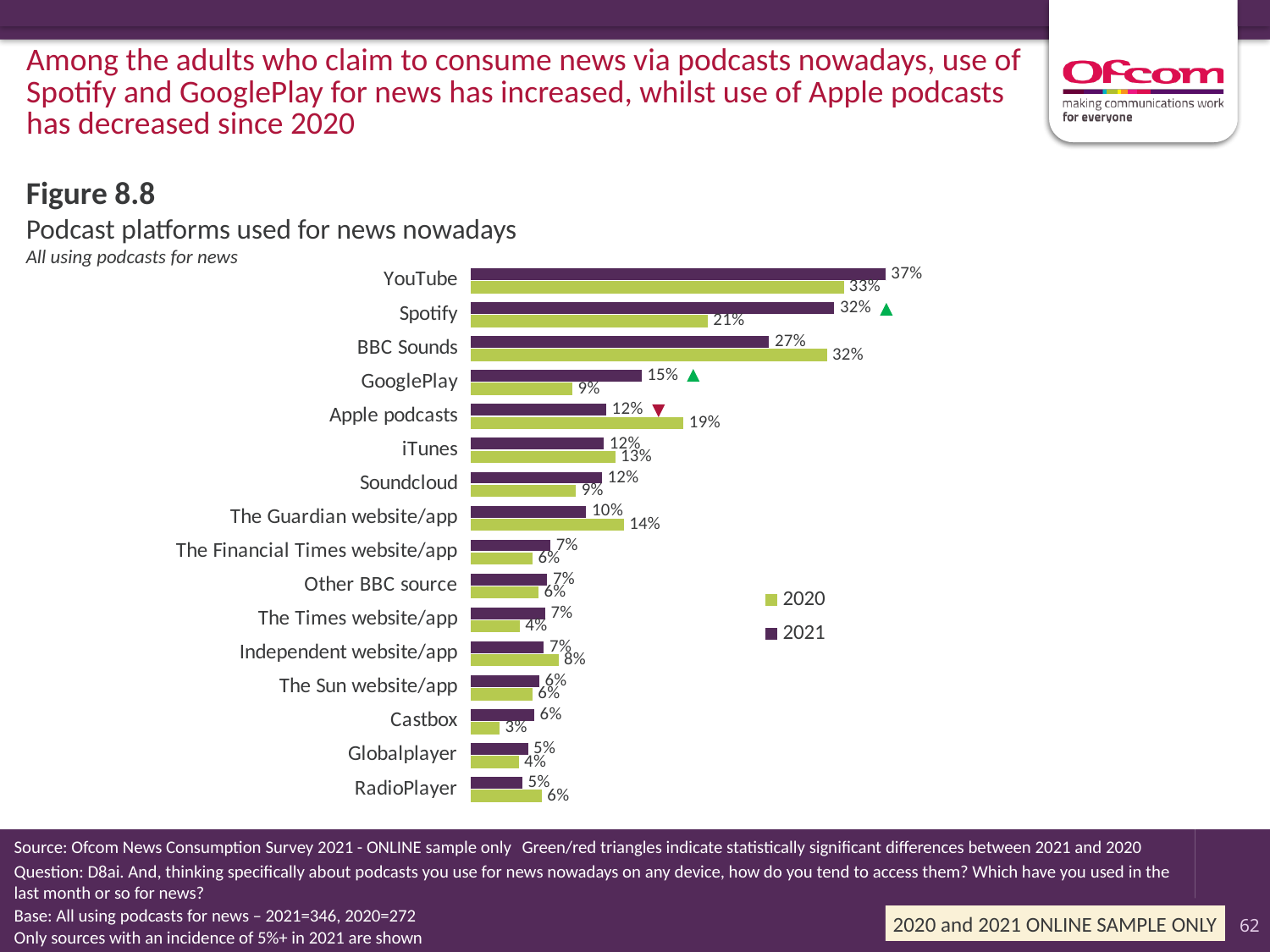
What was the 2020 value for Apple podcasts? 19% What type of chart is shown? Bar chart What percentage used Spotify for news podcasts in 2020? 21% What is the difference between the 2021 and 2020 values for GooglePlay? 6 percentage points Which podcast platform had the highest value in 2021? YouTube Which colour represents 2021 in the chart? Purple How many podcast platforms are listed in the chart? 16 What percentage used YouTube for news podcasts in 2021? 37% How many series does the legend list? 2 Which platform had the lowest value in 2020? Castbox By how many percentage points did Spotify's value change from 2020 to 2021? 11 percentage points Which was larger for BBC Sounds, the 2020 value or the 2021 value? 2020